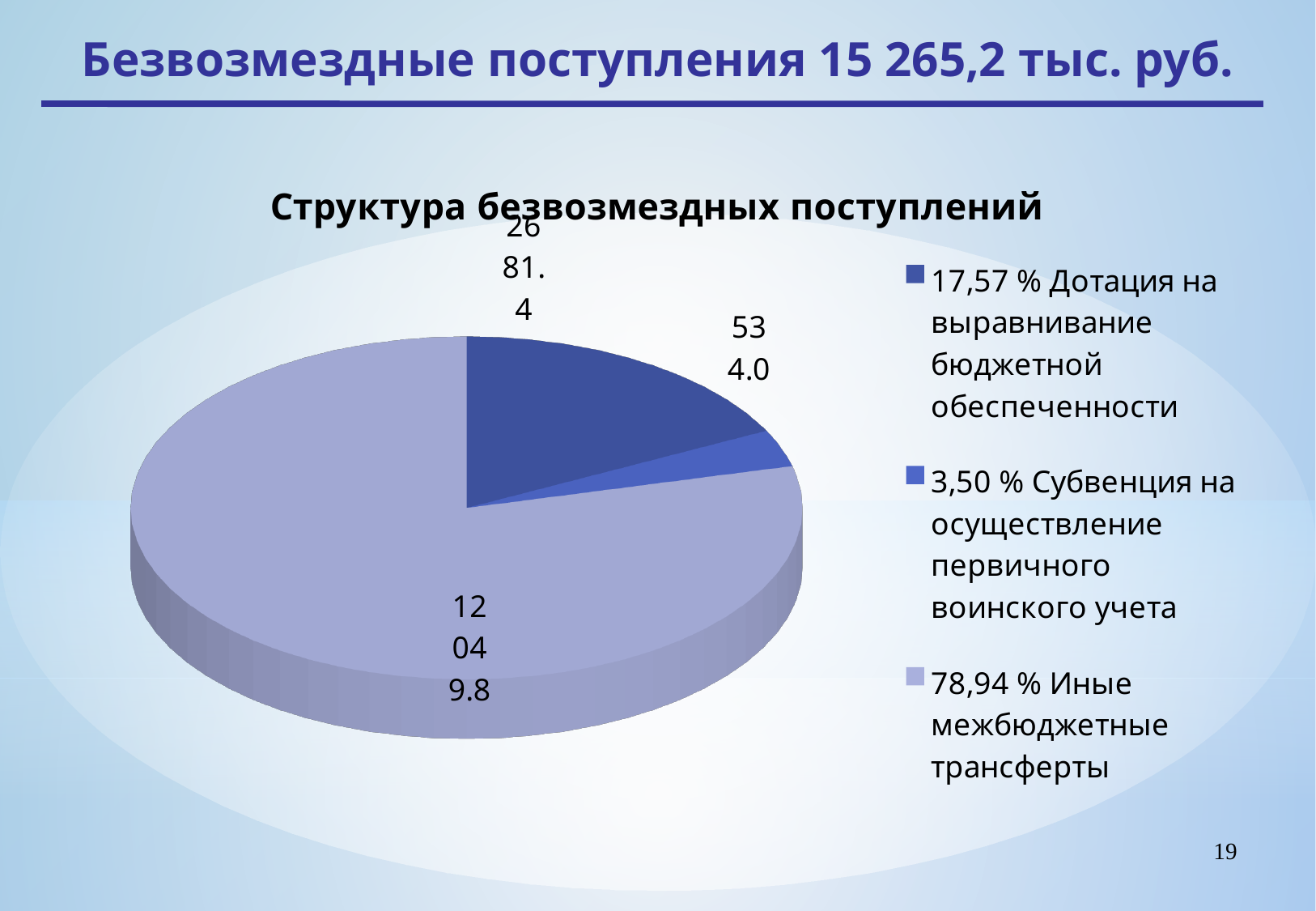
How many slices does the pie chart have? 3 What share of the pie does Иные межбюджетные трансферты account for? 78,94 % What is the value labelled on the slice for Субвенция на осуществление первичного воинского учета? 534.0 What share of the pie does Субвенция на осуществление первичного воинского учета account for? 3,50 % Which category has the largest slice of the pie? Иные межбюджетные трансферты What is the value labelled on the slice for Иные межбюджетные трансферты? 12049.8 What kind of chart is shown on the slide? pie chart What share of the pie does Дотация на выравнивание бюджетной обеспеченности account for? 17,57 % Which is larger: the slice for Дотация на выравнивание бюджетной обеспеченности or the slice for Субвенция на осуществление первичного воинского учета? Дотация на выравнивание бюджетной обеспеченности What is the value labelled on the slice for Дотация на выравнивание бюджетной обеспеченности? 2681.4 Which category has the smallest slice of the pie? Субвенция на осуществление первичного воинского учета What is the title of the pie chart? Структура безвозмездных поступлений